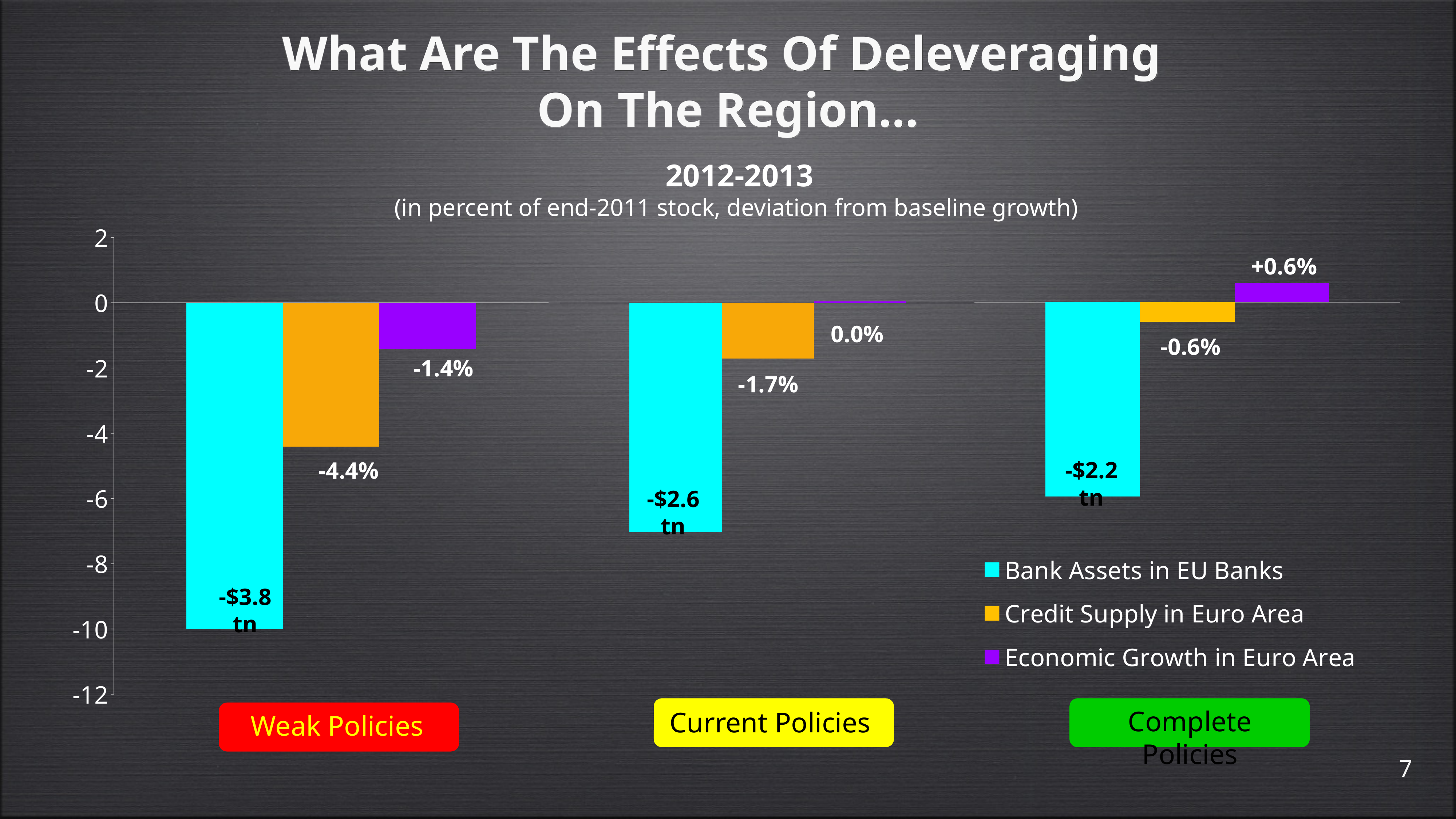
What is the data label for Bank Assets in EU Banks under Current Policies? -$2.6 tn Do the Credit Supply in Euro Area values rise or fall moving from Weak Policies to Complete Policies? rise Under which policy scenario is Credit Supply in Euro Area lowest? Weak Policies What is the difference between the Credit Supply in Euro Area values under Weak Policies and Current Policies? 2.7 percentage points What is the value for Credit Supply in Euro Area under Weak Policies? -4.4% How many policy scenarios (categories) are shown on the x axis? 3 How many series does the legend list? 3 Which is larger: Economic Growth in Euro Area under Weak Policies or under Complete Policies? Complete Policies What kind of chart is shown on the slide? bar chart What is the value for Economic Growth in Euro Area under Complete Policies? +0.6% What is the value for Economic Growth in Euro Area under Current Policies? 0.0% Under which policy scenario is Economic Growth in Euro Area highest? Complete Policies